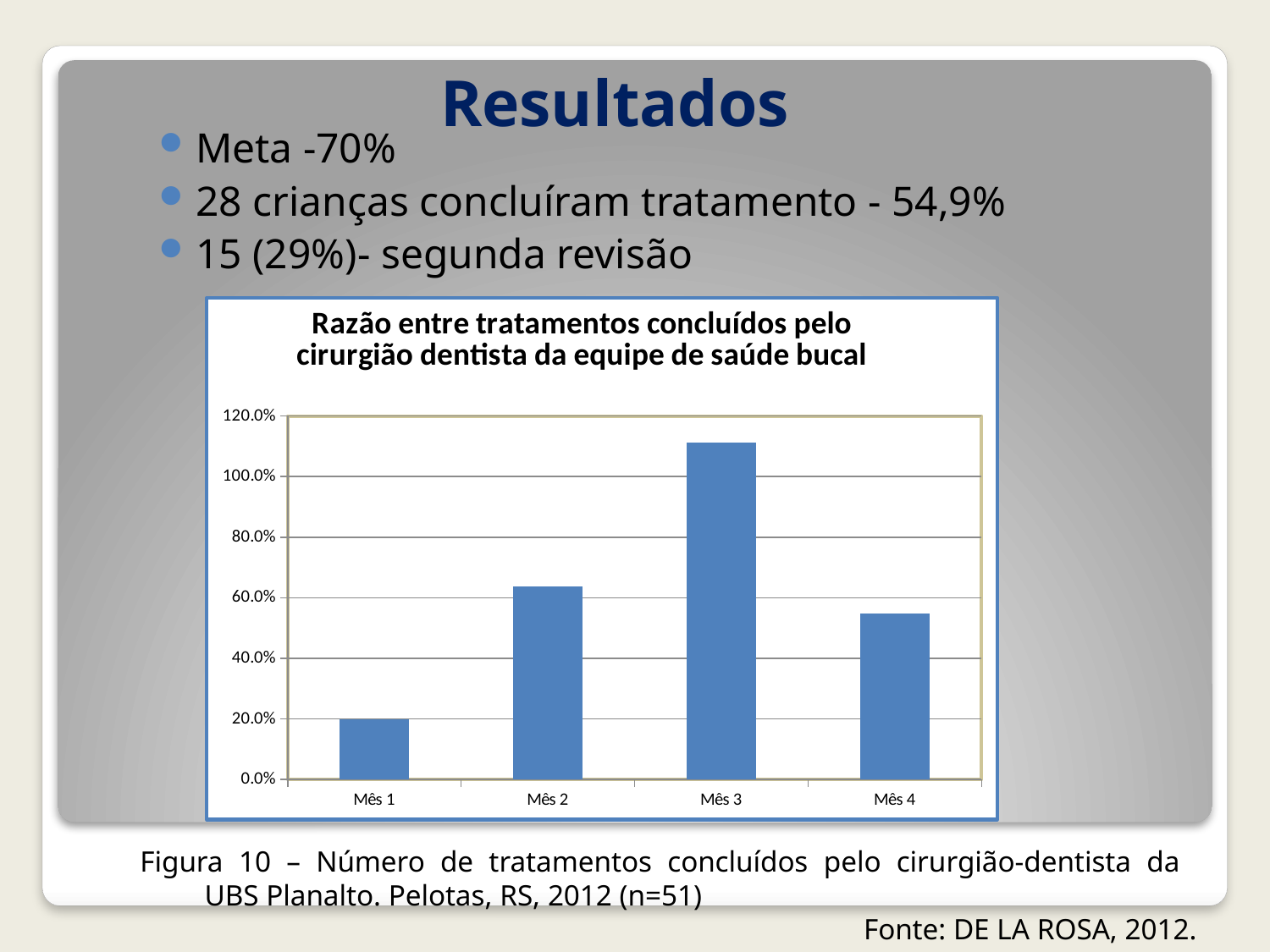
Which month has the highest value in the chart? Mês 3 Is the value for Mês 1 greater or less than 40.0%? less Is the value for Mês 3 greater or less than 100.0%? greater What kind of chart is shown on the slide? bar chart Is the value for Mês 4 greater or less than 60.0%? less Which has a larger value, Mês 3 or Mês 2? Mês 3 Do the values rise or fall from Mês 3 to Mês 4? fall What is the highest value shown on the chart's vertical axis? 120.0% Which month has the lowest value in the chart? Mês 1 How many months (categories) are plotted in the chart? 4 Which has a larger value, Mês 2 or Mês 4? Mês 2